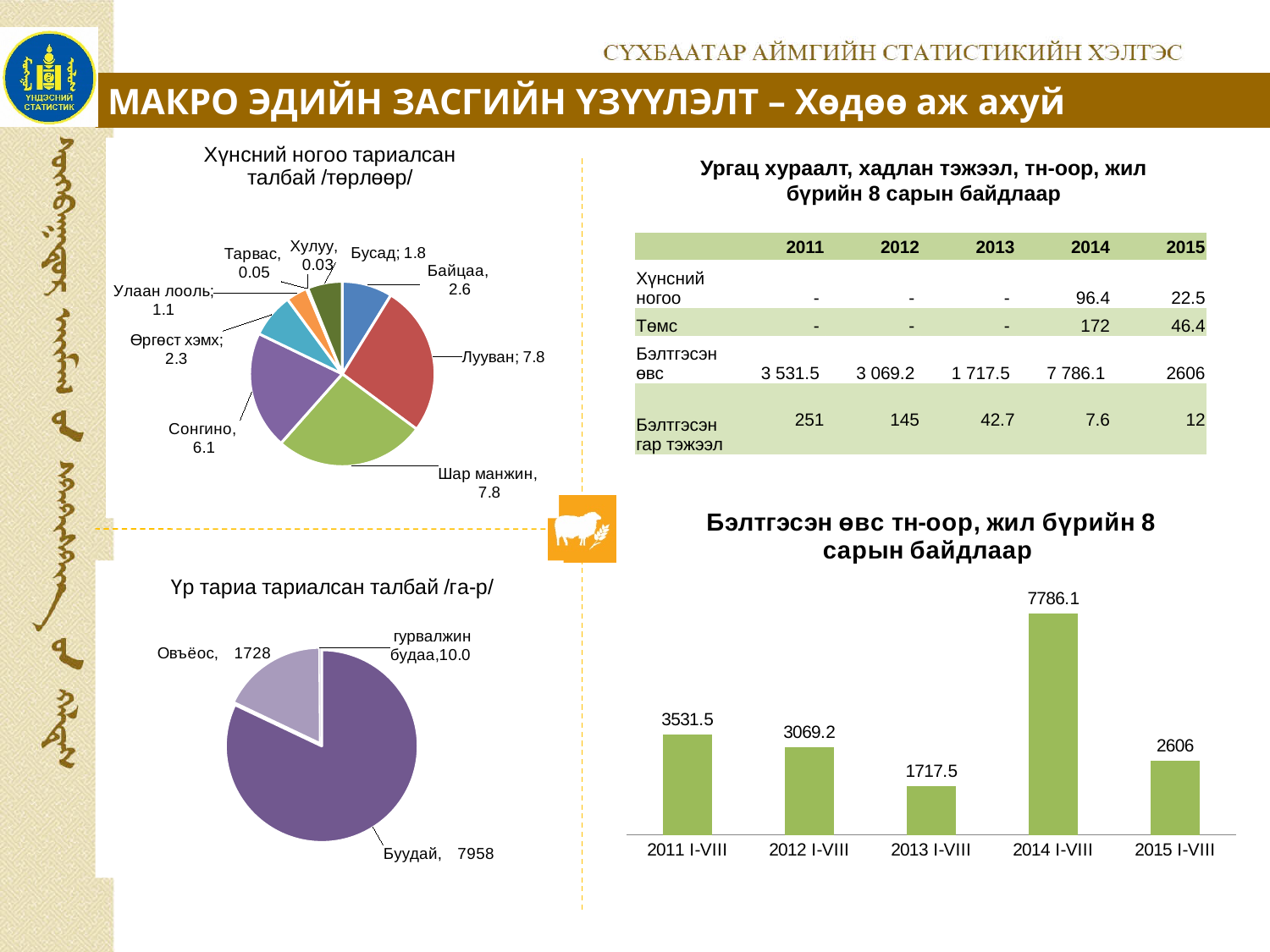
In the pie chart 'Хүнсний ногоо тариалсан талбай /төрлөөр/', which category has the smallest value? Хулуу In the bar chart 'Бэлтгэсэн өвс тн-оор, жил бүрийн 8 сарын байдлаар', which year has the highest value? 2014 I-VIII In the bar chart 'Бэлтгэсэн өвс тн-оор, жил бүрийн 8 сарын байдлаар', is the value for 2012 I-VIII larger or smaller than the value for 2015 I-VIII? larger What kind of chart is 'Бэлтгэсэн өвс тн-оор, жил бүрийн 8 сарын байдлаар'? bar chart In the bar chart 'Бэлтгэсэн өвс тн-оор, жил бүрийн 8 сарын байдлаар', what is the value for 2014 I-VIII? 7786.1 In the pie chart 'Үр тариа тариалсан талбай /га-р/', which category has the largest value? Буудай In the bar chart 'Бэлтгэсэн өвс тн-оор, жил бүрийн 8 сарын байдлаар', which year has the lowest value? 2013 I-VIII In the pie chart 'Хүнсний ногоо тариалсан талбай /төрлөөр/', what is the value for Сонгино? 6.1 In the bar chart 'Бэлтгэсэн өвс тн-оор, жил бүрийн 8 сарын байдлаар', what is the difference between the 2014 I-VIII and 2013 I-VIII values? 6068.6 In the pie chart 'Үр тариа тариалсан талбай /га-р/', what is the difference between the values for Буудай and Овъёос? 6230 In the pie chart 'Хүнсний ногоо тариалсан талбай /төрлөөр/', how many categories are shown? 9 In the bar chart 'Бэлтгэсэн өвс тн-оор, жил бүрийн 8 сарын байдлаар', how many bars are shown? 5